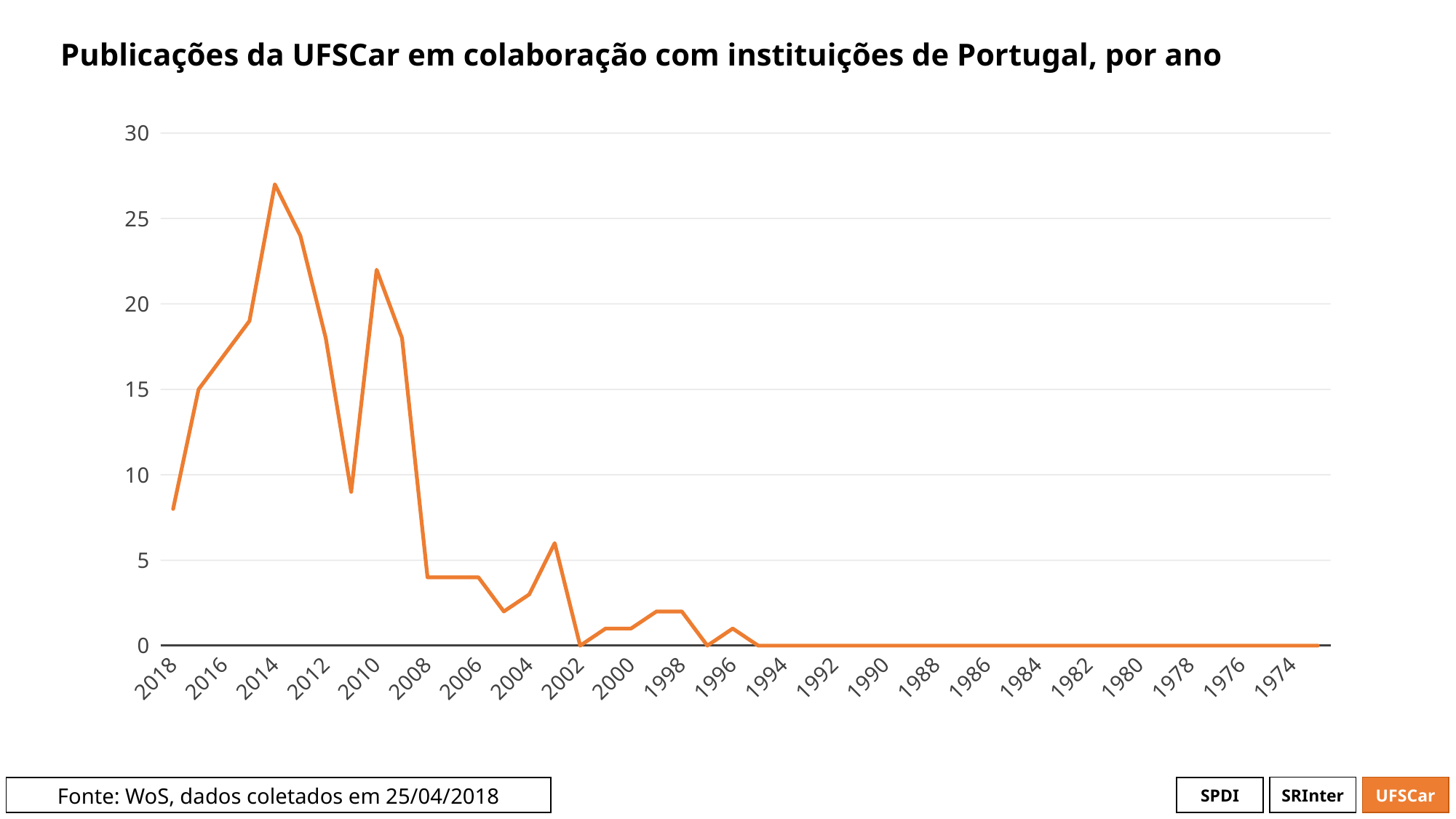
What kind of chart is shown on the slide? line chart Is the value for 2010 greater or less than 20? greater What is the value for 1990? 0 Is the value for 2014 greater or less than 25? greater Is the value for 2008 greater or less than 5? less Which is larger, the value for 2016 or the value for 2008? 2016 What is the title of the chart? Publicações da UFSCar em colaboração com instituições de Portugal, por ano How many year labels are shown on the x axis? 23 Which year has the highest number of publications? 2014 Do the values generally rise or fall moving from 2018 on the left to 1974 on the right? fall